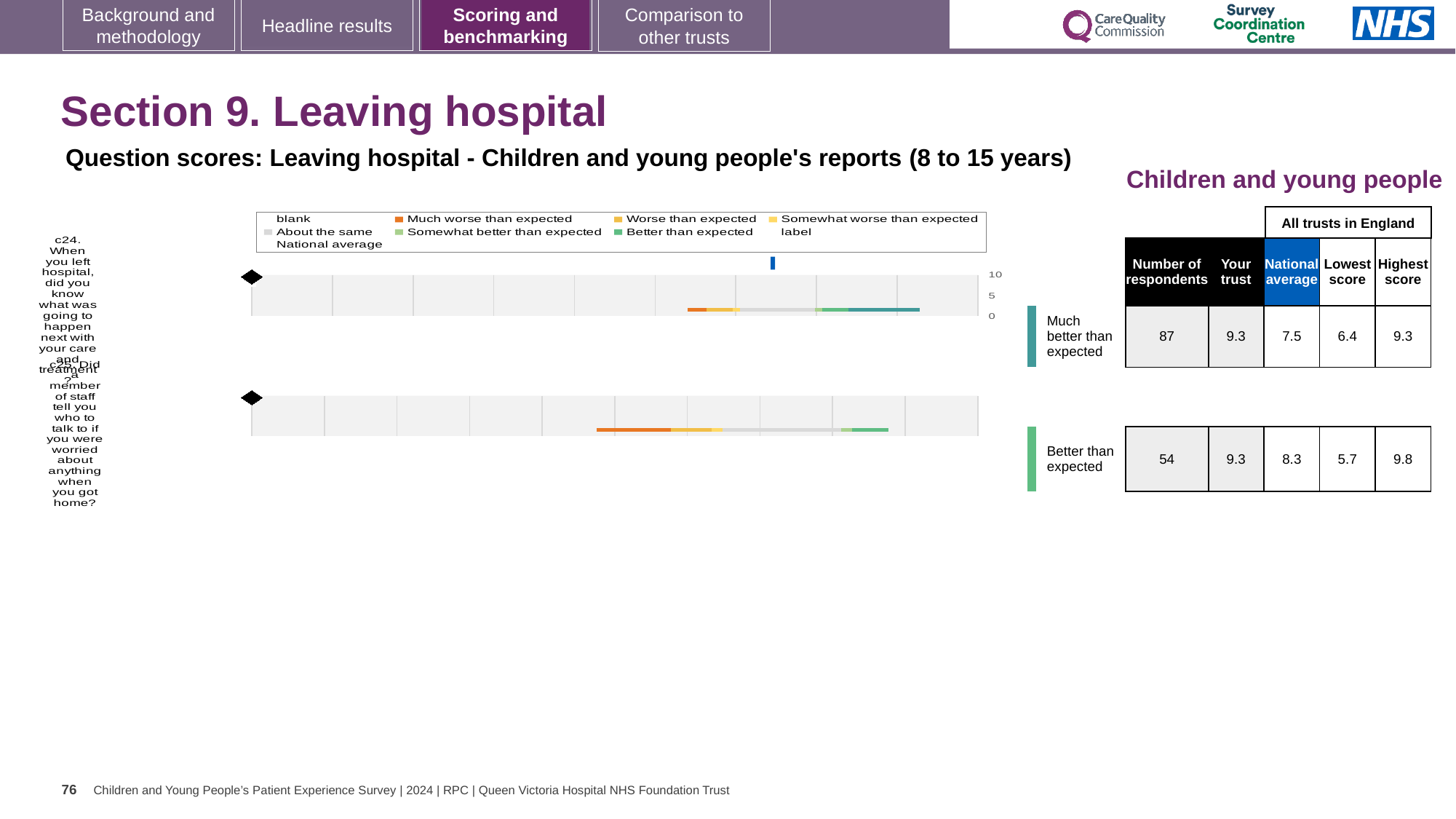
What type of chart is used to show the question scores? Bar chart Which benchmark category is question c24 placed in? Much better than expected What is the difference between the highest and lowest scores for question c25? 4.1 Which question has the higher national average, c24 or c25? c25 What is the 'Your trust' score for question c25 (Did a member of staff tell you who to talk to if you were worried about anything when you got home?)? 9.3 By how much does the trust's score for c24 exceed the national average for c24? 1.8 How many questions are plotted on the chart? 2 Which question has more respondents, c24 or c25? c24 What is the national average score for question c24? 7.5 What is the lowest score among all trusts in England for question c25? 5.7 What is the highest score among all trusts in England for question c24? 9.3 How many respondents answered question c24 (When you left hospital, did you know what was going to happen next with your care and treatment?)? 87